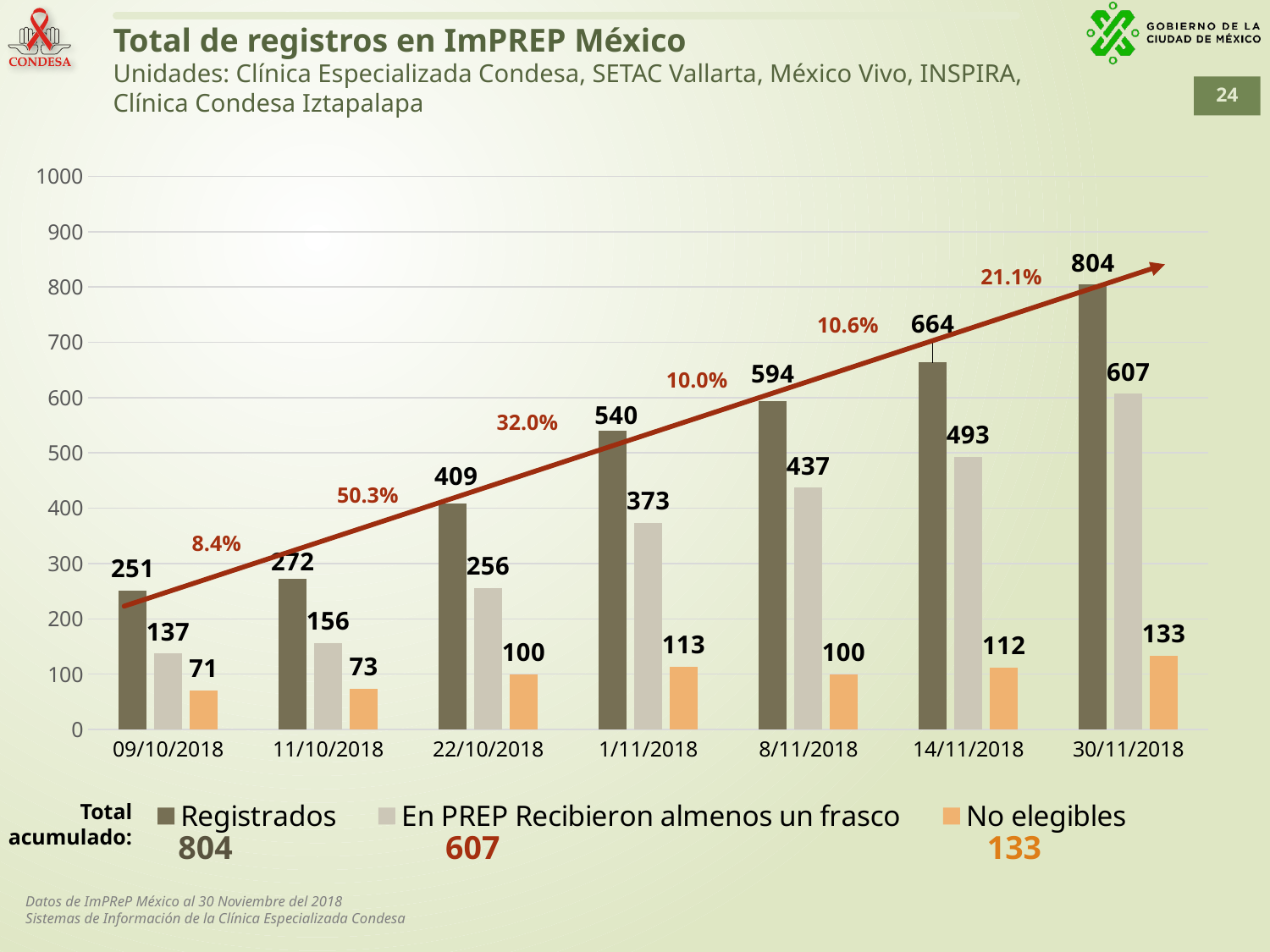
What kind of chart is shown on the slide? Bar chart Do the Registrados values rise or fall from 09/10/2018 to 30/11/2018? Rise On which date is the No elegibles value highest? 30/11/2018 What is the value of Registrados on 30/11/2018? 804 What is the value of 'En PREP Recibieron almenos un frasco' on 8/11/2018? 437 What is the value of No elegibles on 22/10/2018? 100 What is the difference between Registrados on 14/11/2018 and on 8/11/2018? 70 Which is larger: 'En PREP Recibieron almenos un frasco' on 1/11/2018 or Registrados on 11/10/2018? En PREP Recibieron almenos un frasco on 1/11/2018 On which date is the Registrados value lowest? 09/10/2018 What percentage growth is labelled between 11/10/2018 and 22/10/2018? 50.3% How many series does the legend list? 3 How many dates are shown on the x axis? 7